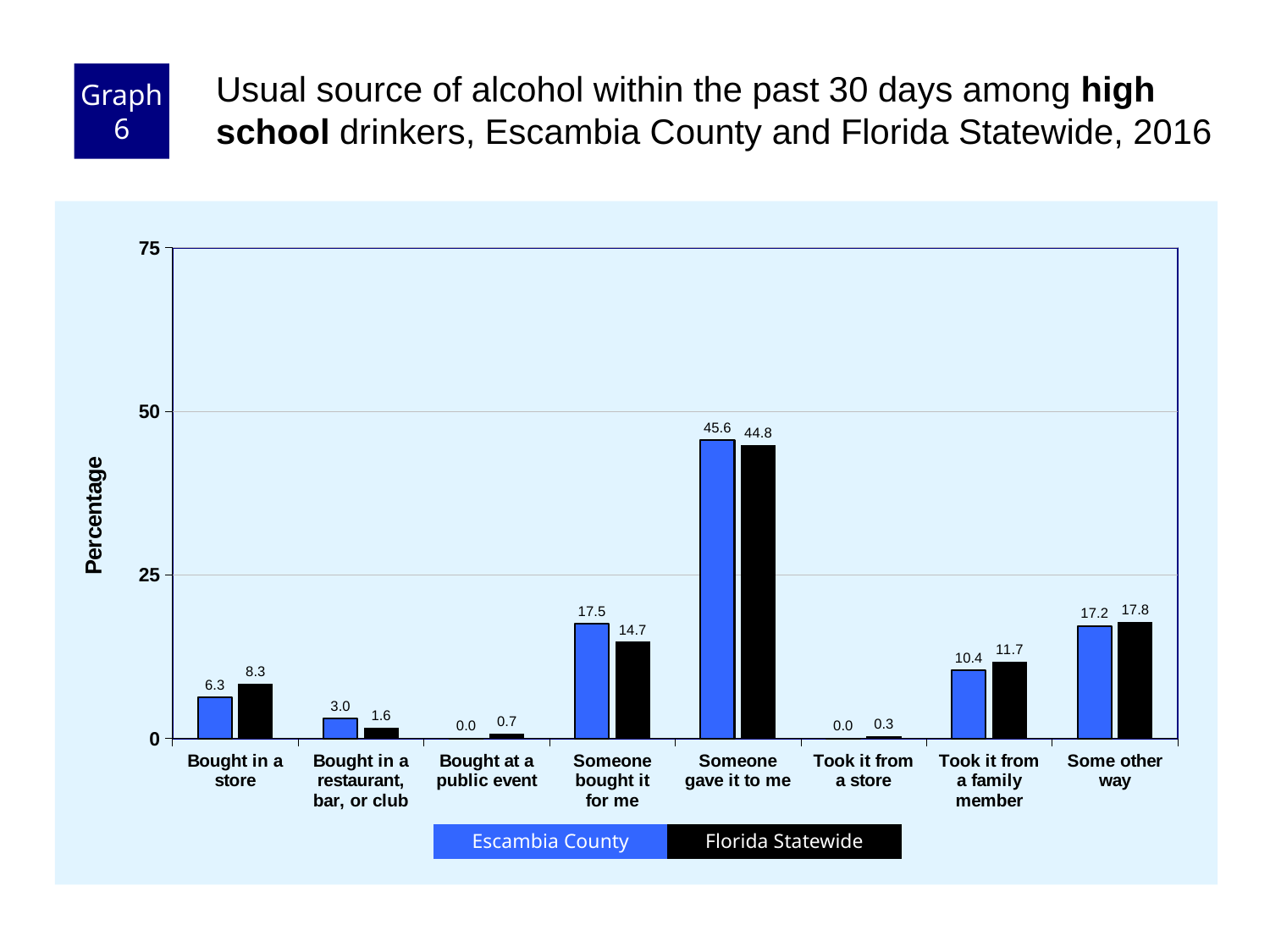
How many source categories are shown on the x axis? 8 What is the difference between the Escambia County and Florida Statewide values for "Someone bought it for me"? 2.8 Which category has the highest Florida Statewide value? Someone gave it to me What is the Escambia County value for "Bought in a restaurant, bar, or club"? 3.0 How many series does the legend list? 2 What is the label on the y axis? Percentage For "Bought in a store", which is larger: Escambia County or Florida Statewide? Florida Statewide Which category has the lowest Florida Statewide value? Took it from a store What is the Escambia County value for "Someone gave it to me"? 45.6 What kind of chart is shown on the slide? bar chart What is the Florida Statewide value for "Took it from a family member"? 11.7 Is the Escambia County value for "Someone gave it to me" greater or less than 50? less